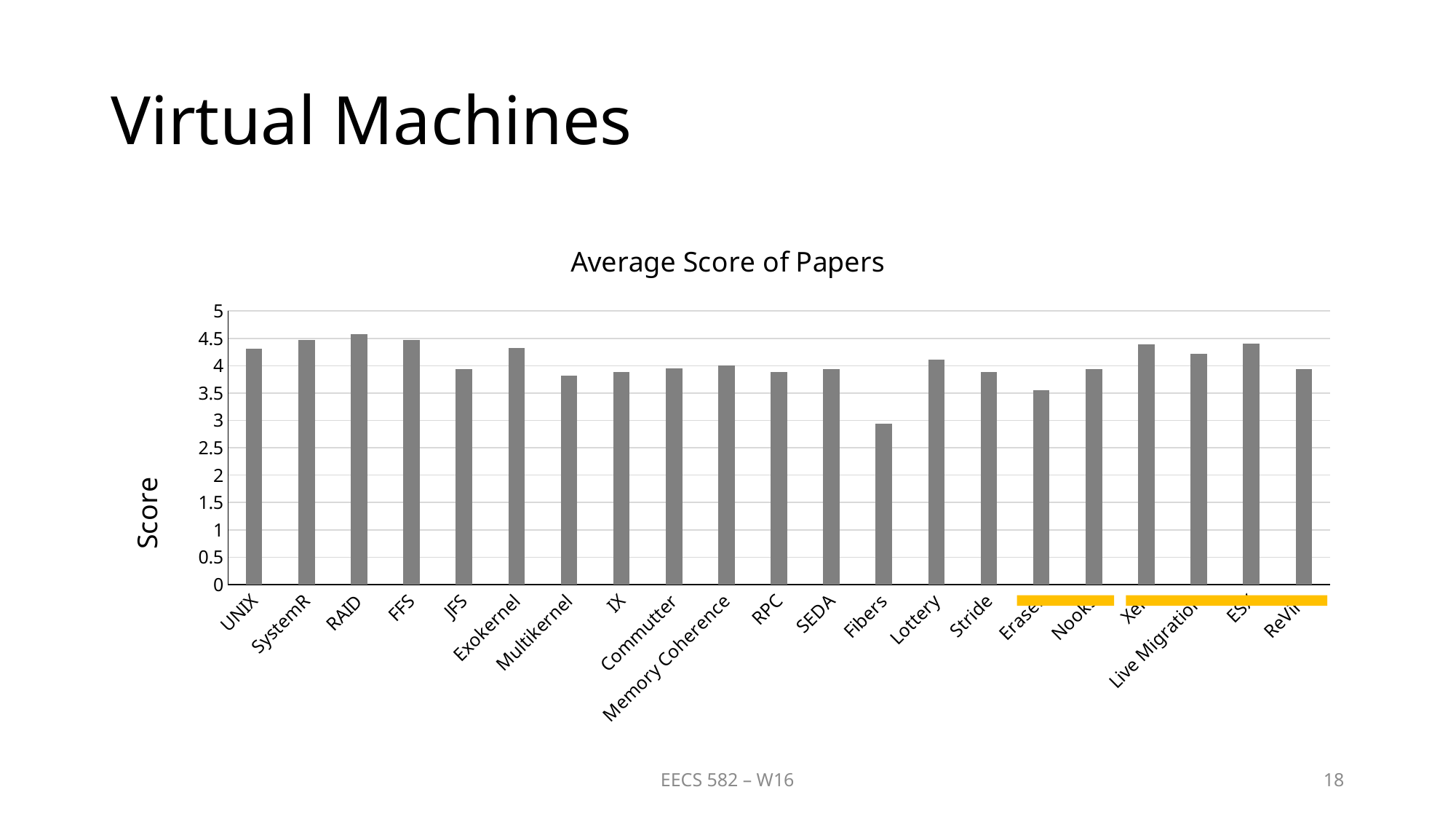
Which paper has the highest average score? RAID Is the value for UNIX greater or less than 4? greater What is the title of the chart? Average Score of Papers Which has the higher average score, Exokernel or Stride? Exokernel How many papers (bars) are plotted in the chart? 21 Which paper has the lowest average score? Fibers Is the value for Fibers greater or less than 3? less What is the label on the vertical axis of the chart? Score Which has the higher average score, Lottery or Fibers? Lottery Is the value for Multikernel greater or less than 4? less What kind of chart is shown on the slide? bar chart